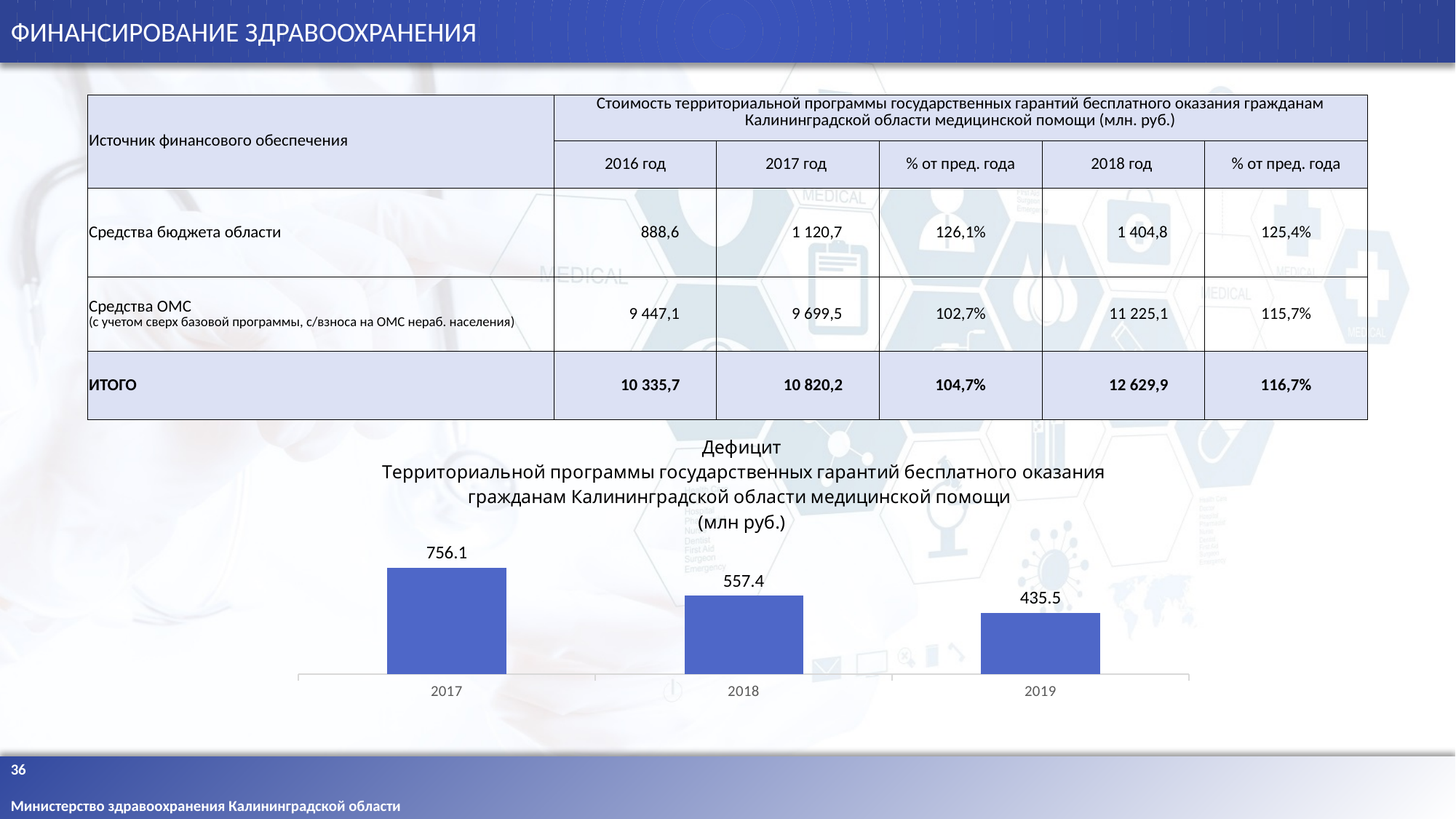
In the bar chart, is the deficit for 2018 larger or smaller than the deficit for 2019? larger What is the deficit value shown for 2017 in the bar chart? 756.1 Which year has the highest deficit in the bar chart? 2017 Which year has the lowest deficit in the bar chart? 2019 In what units are the values in the deficit bar chart expressed, according to its title? млн руб. What is the deficit value shown for 2019 in the bar chart? 435.5 What is the difference between the deficit values for 2018 and 2019 in the bar chart? 121.9 Do the deficit values rise or fall from 2017 to 2019 in the bar chart? fall What type of chart is used to show the deficit on the slide? bar chart How many years (bars) are shown in the bar chart? 3 What is the deficit value shown for 2018 in the bar chart? 557.4 What is the difference between the deficit values for 2017 and 2018 in the bar chart? 198.7